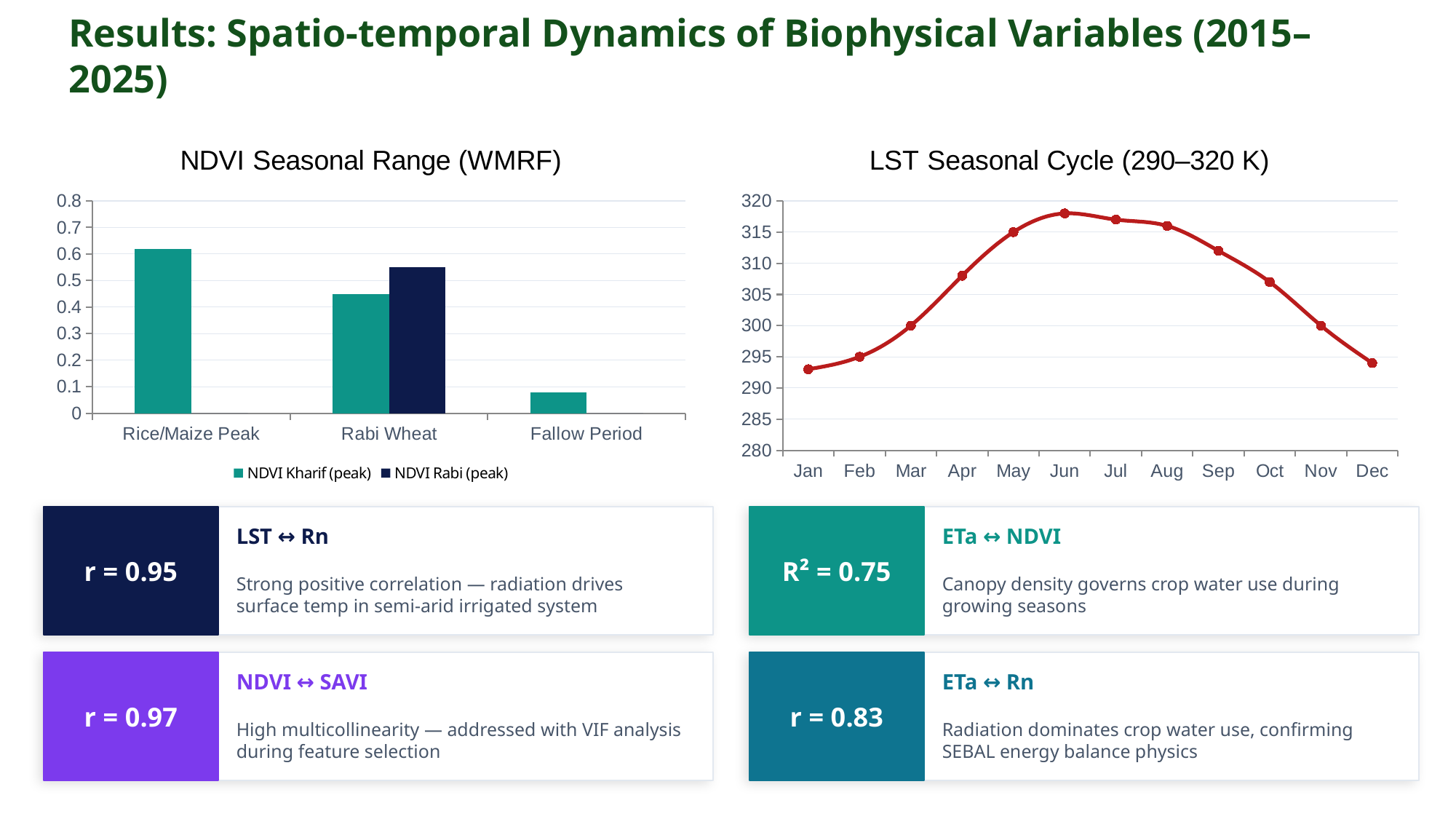
In the LST Seasonal Cycle (290–320 K) chart, which month has the lowest value? Jan In the LST Seasonal Cycle (290–320 K) chart, do the values rise or fall from Jan to Jun? Rise In the LST Seasonal Cycle (290–320 K) chart, how many months are plotted along the x axis? 12 In the NDVI Seasonal Range (WMRF) chart, for Rabi Wheat, which series has the larger value: NDVI Kharif (peak) or NDVI Rabi (peak)? NDVI Rabi (peak) In the NDVI Seasonal Range (WMRF) chart, how many categories are shown on the x axis? 3 What kind of chart is the LST Seasonal Cycle (290–320 K) chart on the right? Line chart In the LST Seasonal Cycle (290–320 K) chart, is the value for Apr greater or less than 305? greater In the NDVI Seasonal Range (WMRF) chart, how many series does the legend list? 2 In the NDVI Seasonal Range (WMRF) chart, is the NDVI Kharif (peak) value for Fallow Period greater or less than 0.1? less In the NDVI Seasonal Range (WMRF) chart, is the NDVI Kharif (peak) value for Rice/Maize Peak greater or less than 0.5? greater In the LST Seasonal Cycle (290–320 K) chart, which month has the highest value? Jun What kind of chart is the NDVI Seasonal Range (WMRF) chart on the left? Bar chart